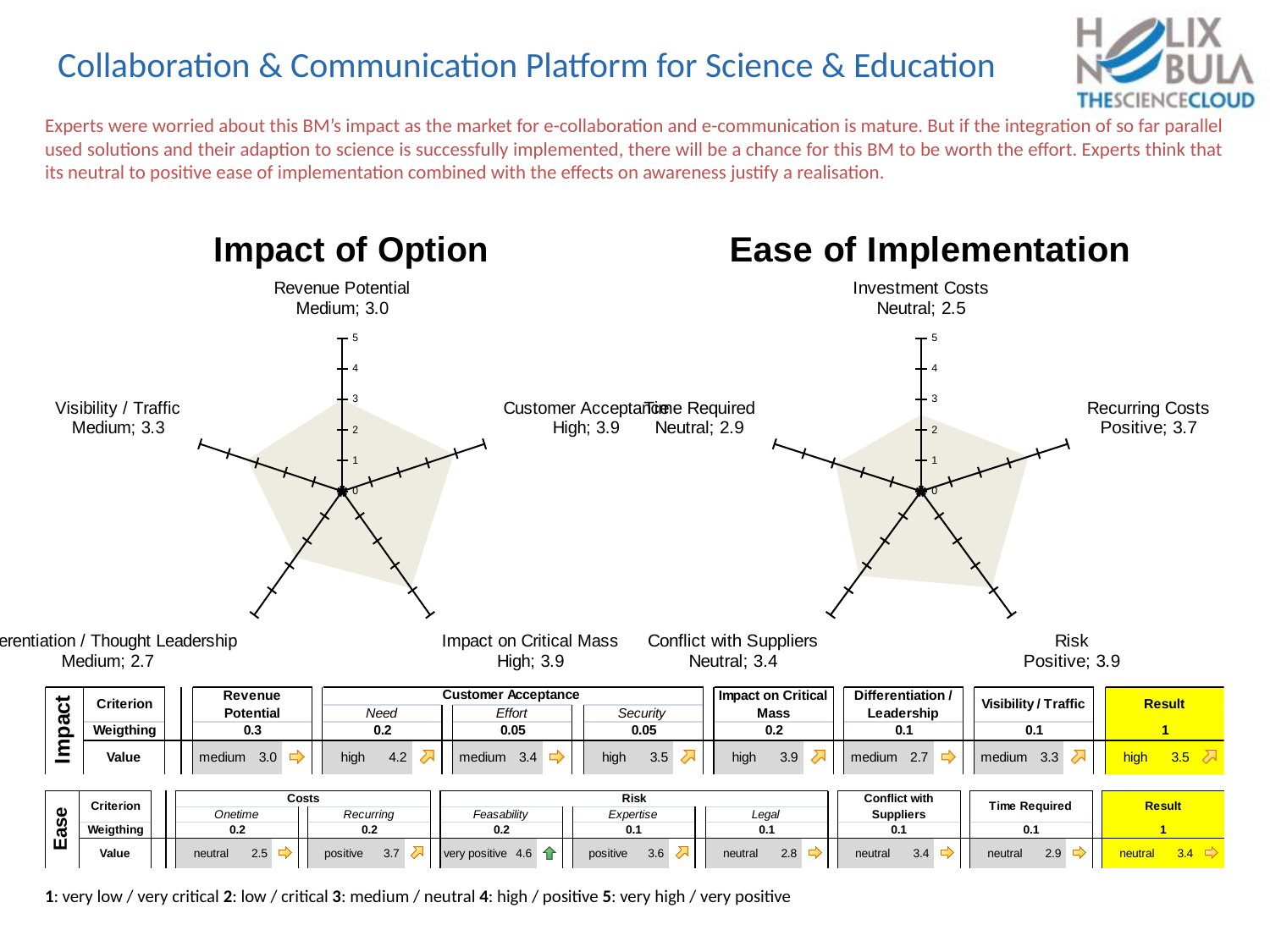
On the Ease of Implementation chart, which criterion has the lowest value? Investment Costs On the Impact of Option chart, what is the value for Visibility / Traffic? 3.3 On the Ease of Implementation chart, what is the difference between the values for Risk and Investment Costs? 1.4 On the Ease of Implementation chart, what is the value for Recurring Costs? 3.7 On the Impact of Option chart, what is the value for Revenue Potential? 3.0 On the Impact of Option chart, which criterion has the lowest value? Differentiation / Thought Leadership What kind of chart is the Impact of Option chart? Radar chart On the Impact of Option chart, which is larger: the value for Visibility / Traffic or the value for Revenue Potential? Visibility / Traffic On the Ease of Implementation chart, how many criteria are plotted? 5 On the Ease of Implementation chart, what rating label is shown for Time Required? Neutral On the Ease of Implementation chart, which criterion has the highest value? Risk On the Ease of Implementation chart, what is the value for Investment Costs? 2.5